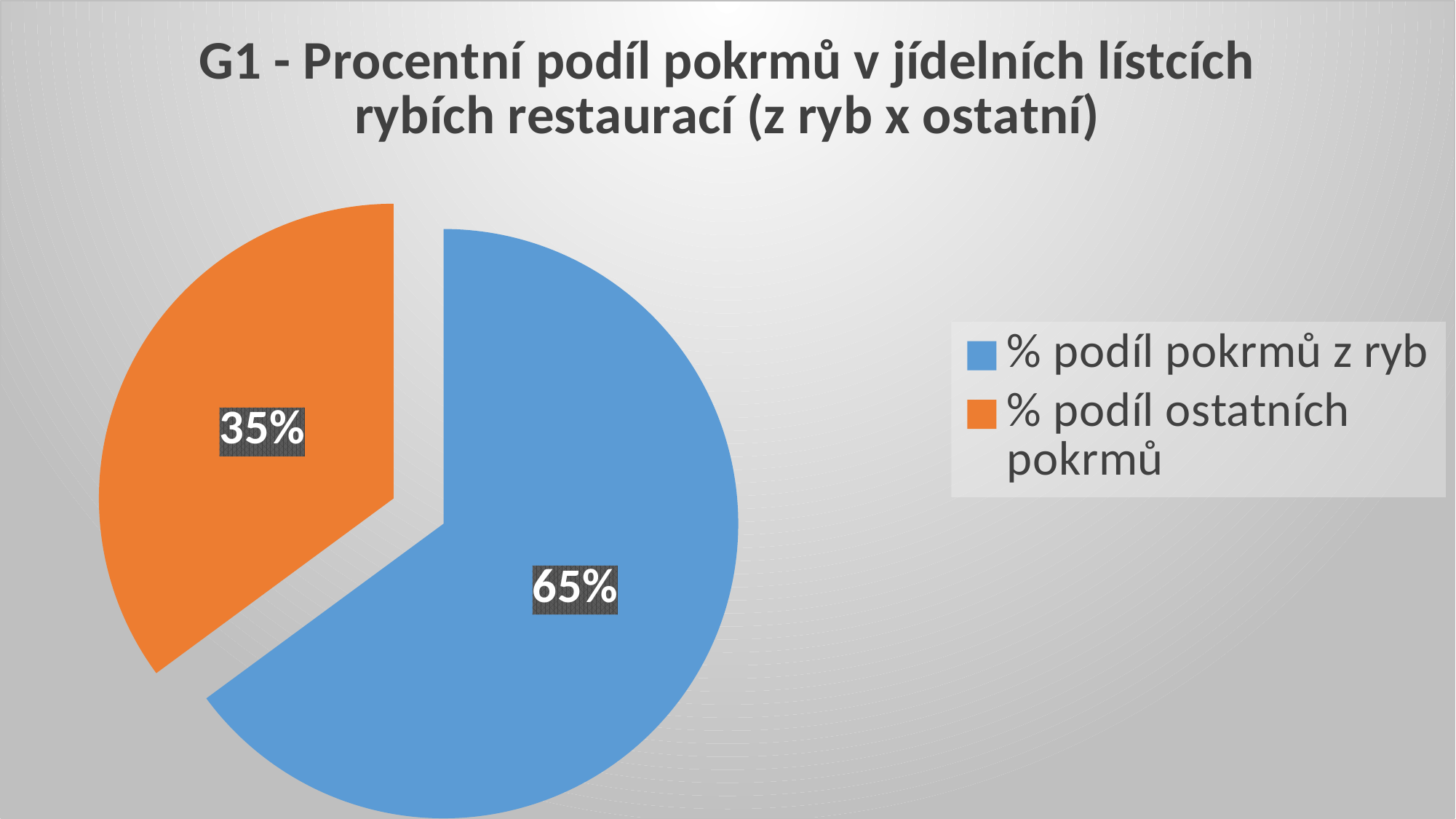
What colour is the slice for "% podíl ostatních pokrmů"? orange What kind of chart is shown on the slide? pie chart Which slice is the smallest? % podíl ostatních pokrmů What is the value for "% podíl ostatních pokrmů"? 35% Which is larger: "% podíl pokrmů z ryb" or "% podíl ostatních pokrmů"? % podíl pokrmů z ryb How many slices does the pie chart have? 2 What share of the pie does "% podíl ostatních pokrmů" represent? 35% What is the title of the chart? G1 - Procentní podíl pokrmů v jídelních lístcích rybích restaurací (z ryb x ostatní) What is the value for "% podíl pokrmů z ryb"? 65% How many entries does the legend list? 2 What is the difference between the share of fish dishes ("% podíl pokrmů z ryb") and other dishes ("% podíl ostatních pokrmů")? 30% Which slice is the largest? % podíl pokrmů z ryb